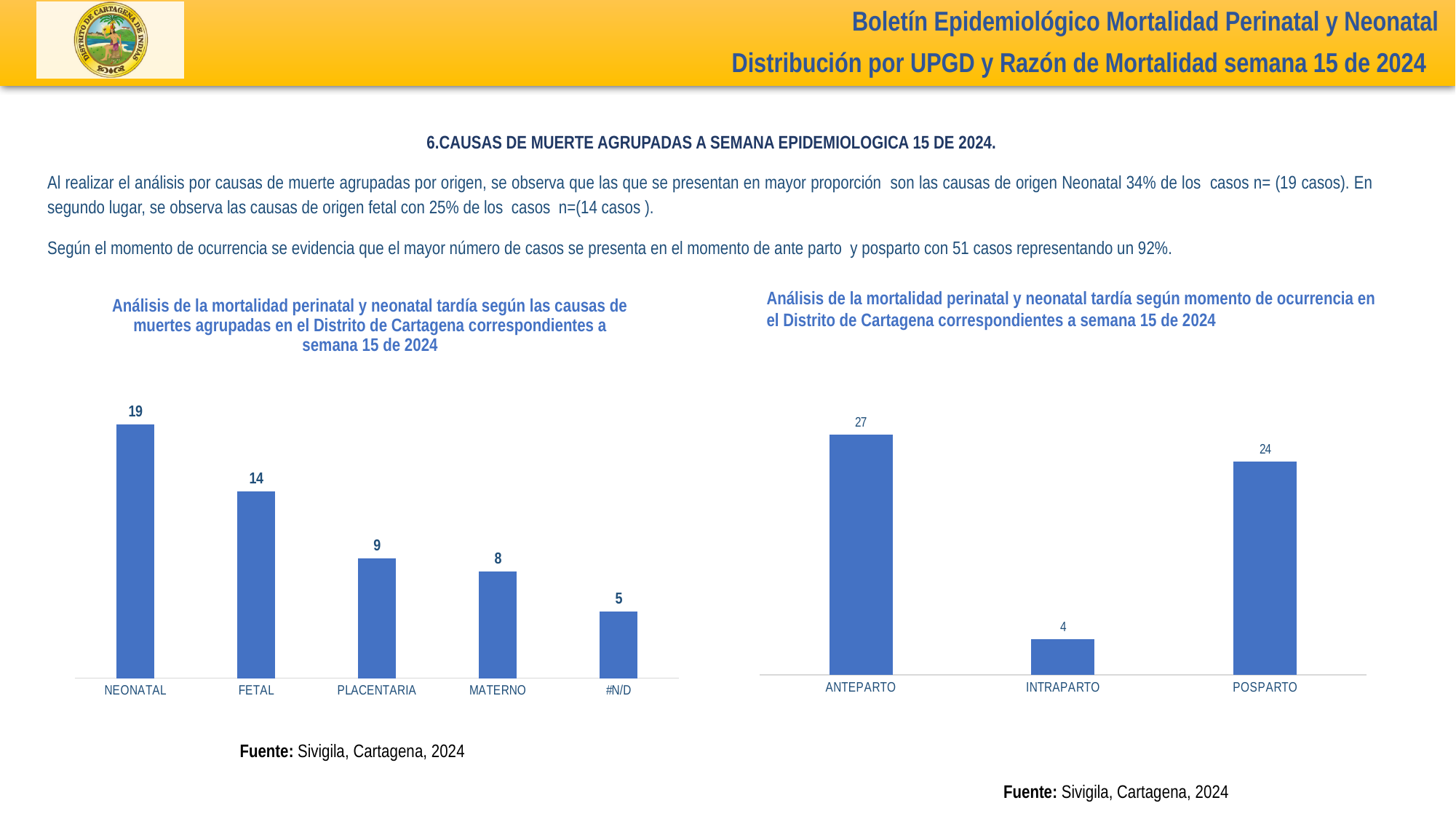
In the left chart (causas de muertes agrupadas), which category has the lowest value? #N/D In the right chart (momento de ocurrencia), which category has the highest value? ANTEPARTO In the left chart (causas de muertes agrupadas), do the values rise or fall from left to right? fall In the right chart (momento de ocurrencia), what is the value for INTRAPARTO? 4 What kind of chart is the right chart (momento de ocurrencia)? bar chart In the left chart (causas de muertes agrupadas), which category has the highest value? NEONATAL In the right chart (momento de ocurrencia), which is larger, POSPARTO or INTRAPARTO? POSPARTO In the right chart (momento de ocurrencia), what is the difference between the values for ANTEPARTO and POSPARTO? 3 In the left chart (causas de muertes agrupadas), what is the difference between the values for NEONATAL and FETAL? 5 In the left chart (causas de muertes agrupadas), what is the value for PLACENTARIA? 9 In the left chart (causas de muertes agrupadas), what is the value for NEONATAL? 19 In the left chart (causas de muertes agrupadas), how many categories are shown? 5